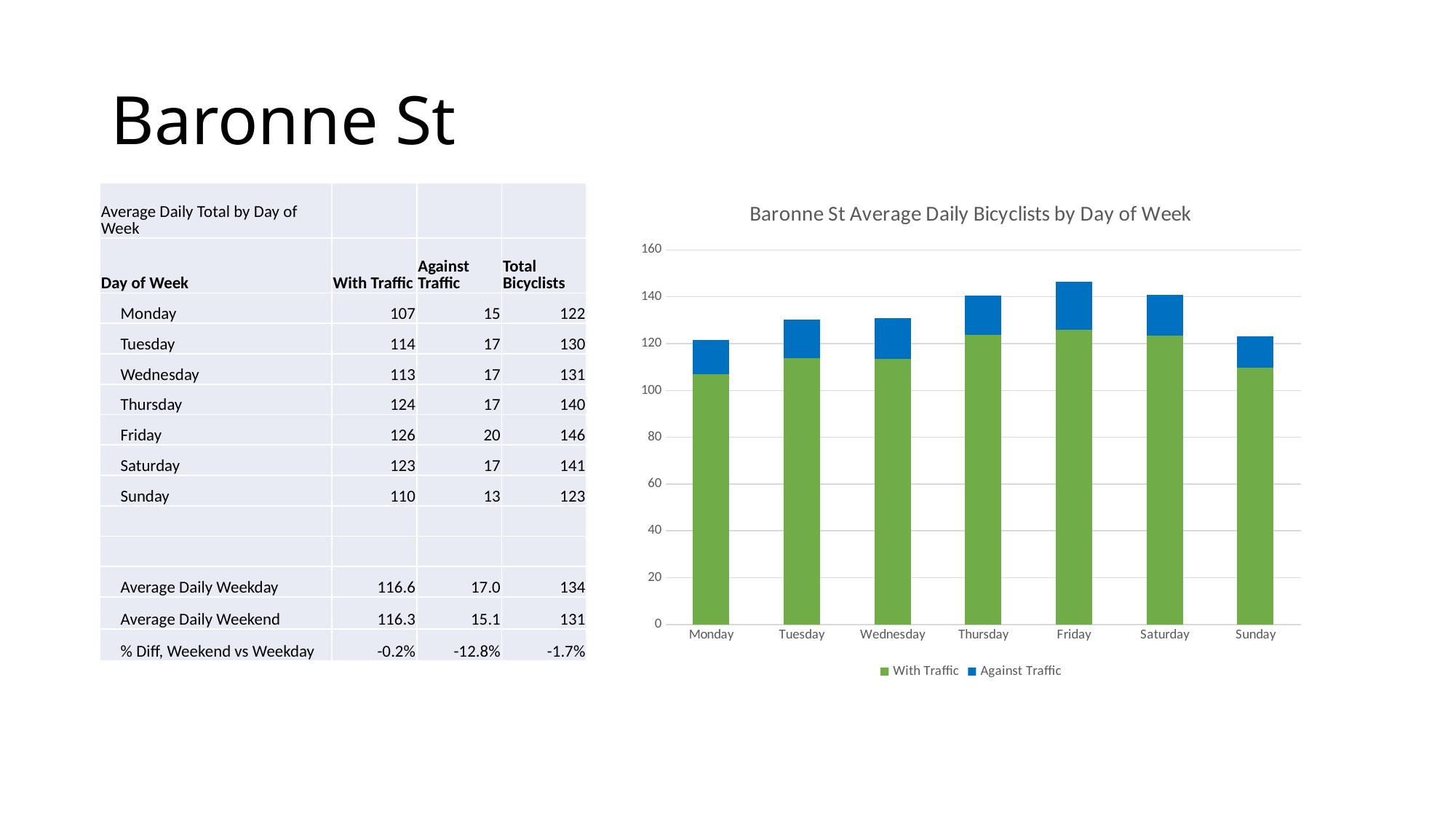
Is the total stacked bar for Friday greater or less than 140? greater What kind of chart is shown on the slide? stacked bar chart What is the total of the stacked bar for Saturday, as printed in the table on the slide? 141 Is the With Traffic value for Monday greater or less than 120? less Which is larger in the chart, the total bar for Thursday or the total bar for Wednesday? Thursday Which day has the lowest total stacked bar in the chart? Monday Which colour represents the Against Traffic series in the chart? blue How many series does the chart legend list? 2 Which day has the highest total stacked bar in the chart? Friday How many days of the week are plotted on the x axis of the chart? 7 What is the With Traffic value for Friday, as printed in the table on the slide? 126 What is the title of the chart? Baronne St Average Daily Bicyclists by Day of Week